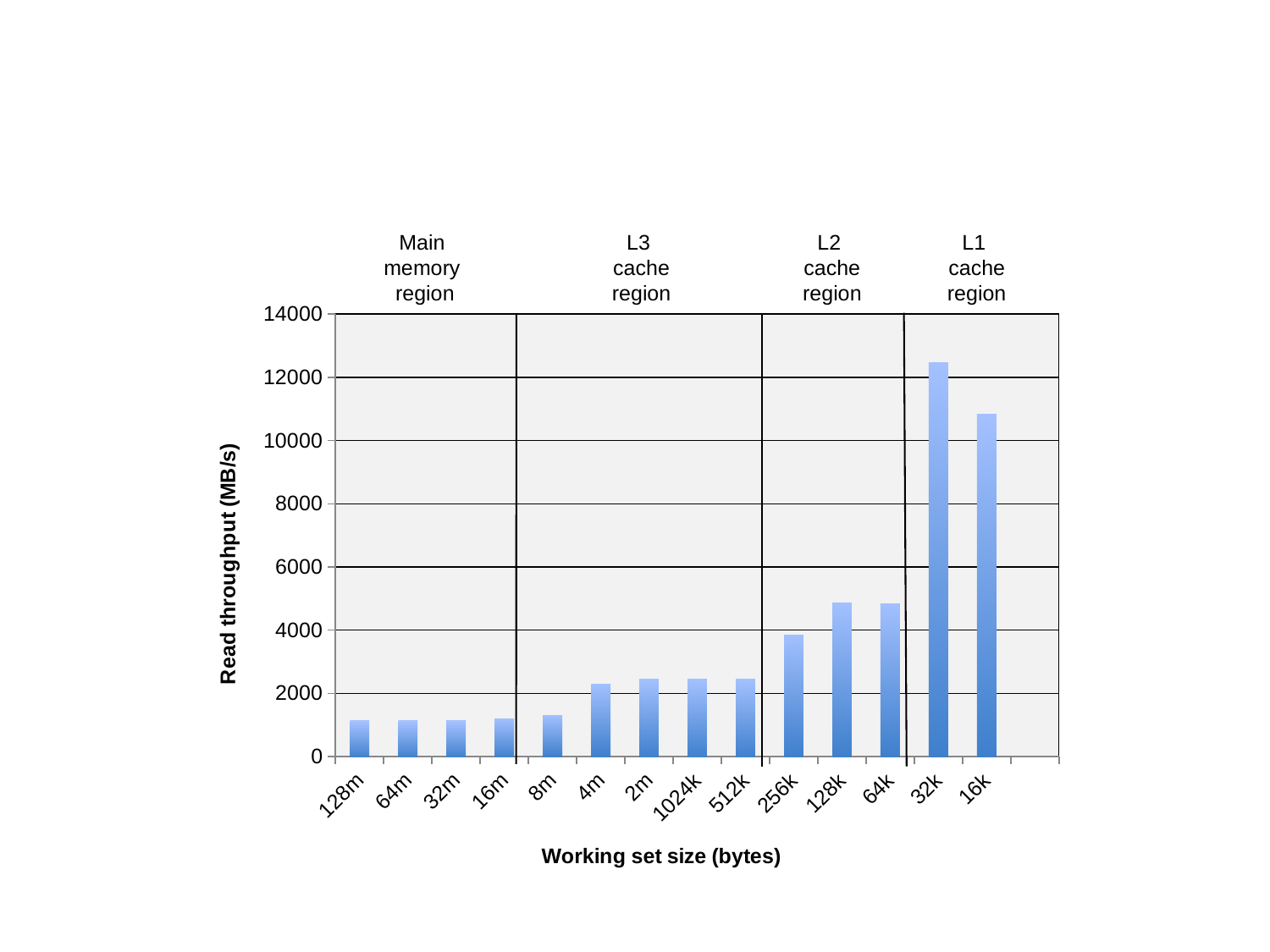
Is the read throughput for 8m greater or less than 2000? less Which has the higher read throughput, 256k or 128k? 128k Is the read throughput for 128k greater or less than 4000? greater Which has the higher read throughput, 32k or 16k? 32k Which working set size has the highest read throughput? 32k What kind of chart is shown on the slide? bar chart Is the read throughput for 16k greater or less than 10000? greater How many working set sizes are plotted along the x axis? 14 Do the read throughput values generally rise or fall moving from left to right along the x axis? rise What is the title of the y axis? Read throughput (MB/s)